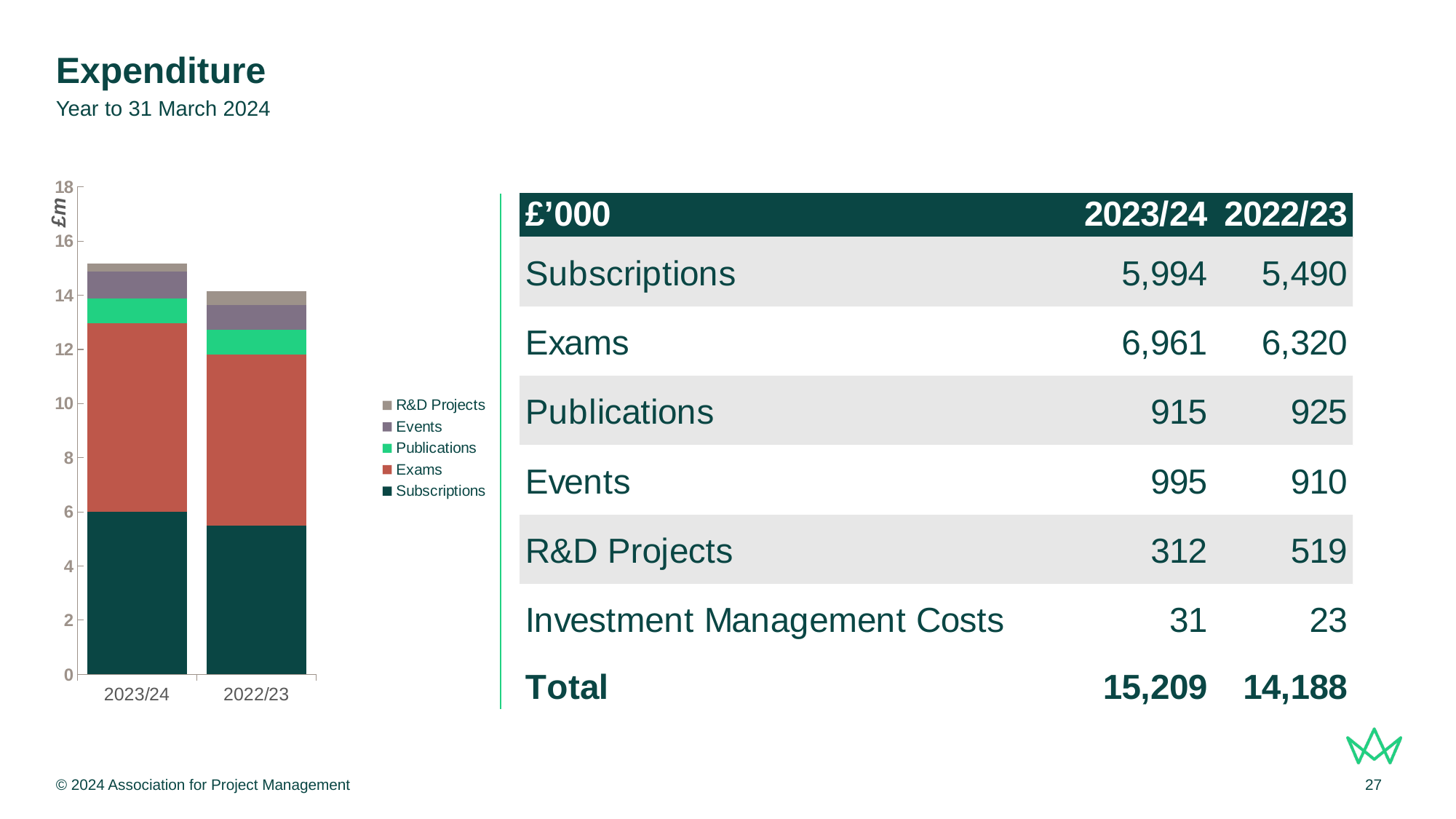
Which series forms the largest segment of the 2023/24 bar? Exams What unit is shown on the chart's y axis? £m Which year has the larger R&D Projects segment, 2023/24 or 2022/23? 2022/23 Is the total height of the 2022/23 bar greater or less than 16? less How many series does the chart legend list? 5 Is the total height of the 2023/24 bar greater or less than 14? greater How many categories are shown on the x axis of the chart? 2 Which series is listed first (at the top) in the chart legend? R&D Projects What kind of chart is shown on the slide? Stacked bar chart Is the Subscriptions segment for 2022/23 greater or less than 4? greater Which series forms the smallest segment of the 2023/24 bar? R&D Projects Which bar is taller overall, 2023/24 or 2022/23? 2023/24